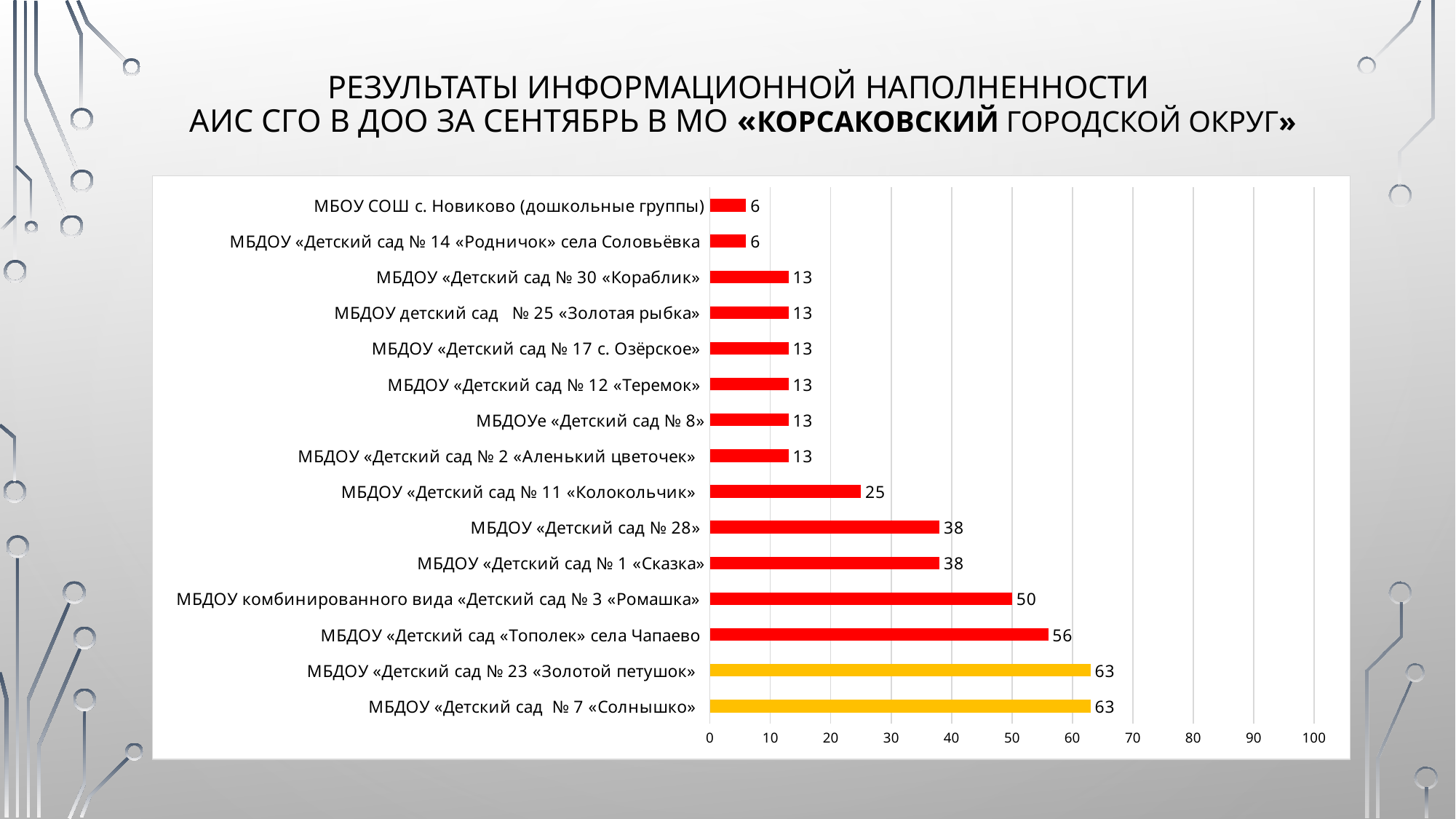
What is the lowest value shown in the chart? 6 How many organisations (categories) are plotted in the chart? 15 What is the highest value shown in the chart? 63 Which has a larger value: МБДОУ «Детский сад № 28» or МБДОУ «Детский сад № 11 «Колокольчик»? МБДОУ «Детский сад № 28» What is the value for МБДОУ комбинированного вида «Детский сад № 3 «Ромашка»? 50 What type of chart is shown on the slide? bar chart What colour are the bars for МБДОУ «Детский сад № 23 «Золотой петушок» and МБДОУ «Детский сад № 7 «Солнышко»? yellow What is the value for МБДОУ «Детский сад «Тополек» села Чапаево? 56 What is the value for МБДОУ «Детский сад № 30 «Кораблик»? 13 What is the value for МБДОУ «Детский сад № 11 «Колокольчик»? 25 What is the difference between the values for МБДОУ «Детский сад «Тополек» села Чапаево and МБДОУ комбинированного вида «Детский сад № 3 «Ромашка»? 6 Is the value for МБДОУ «Детский сад № 1 «Сказка» greater or less than 30? greater